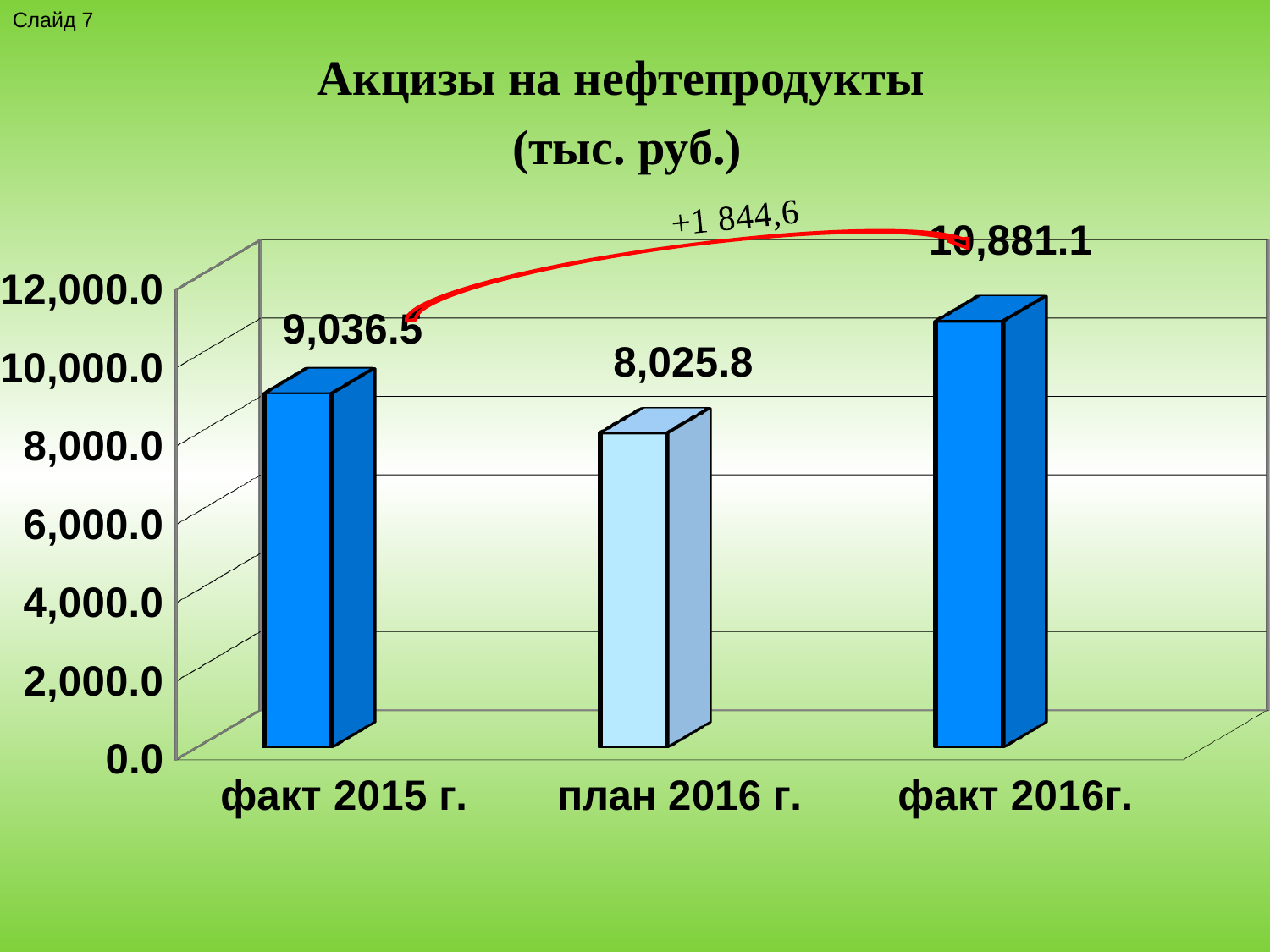
What is the value for план 2016 г.? 8,025.8 Which category has the lowest value? план 2016 г. What is the value for факт 2016г.? 10,881.1 What is the title of the chart? Акцизы на нефтепродукты (тыс. руб.) What kind of chart is shown on the slide? bar chart Which is larger, факт 2015 г. or план 2016 г.? факт 2015 г. Which category has the highest value? факт 2016г. What is the difference between факт 2016г. and факт 2015 г.? 1,844.6 How many bars are shown in the chart? 3 What is the value for факт 2015 г.? 9,036.5 What is the difference between факт 2016г. and план 2016 г.? 2,855.3 Is the value for план 2016 г. greater or less than 10,000.0? less